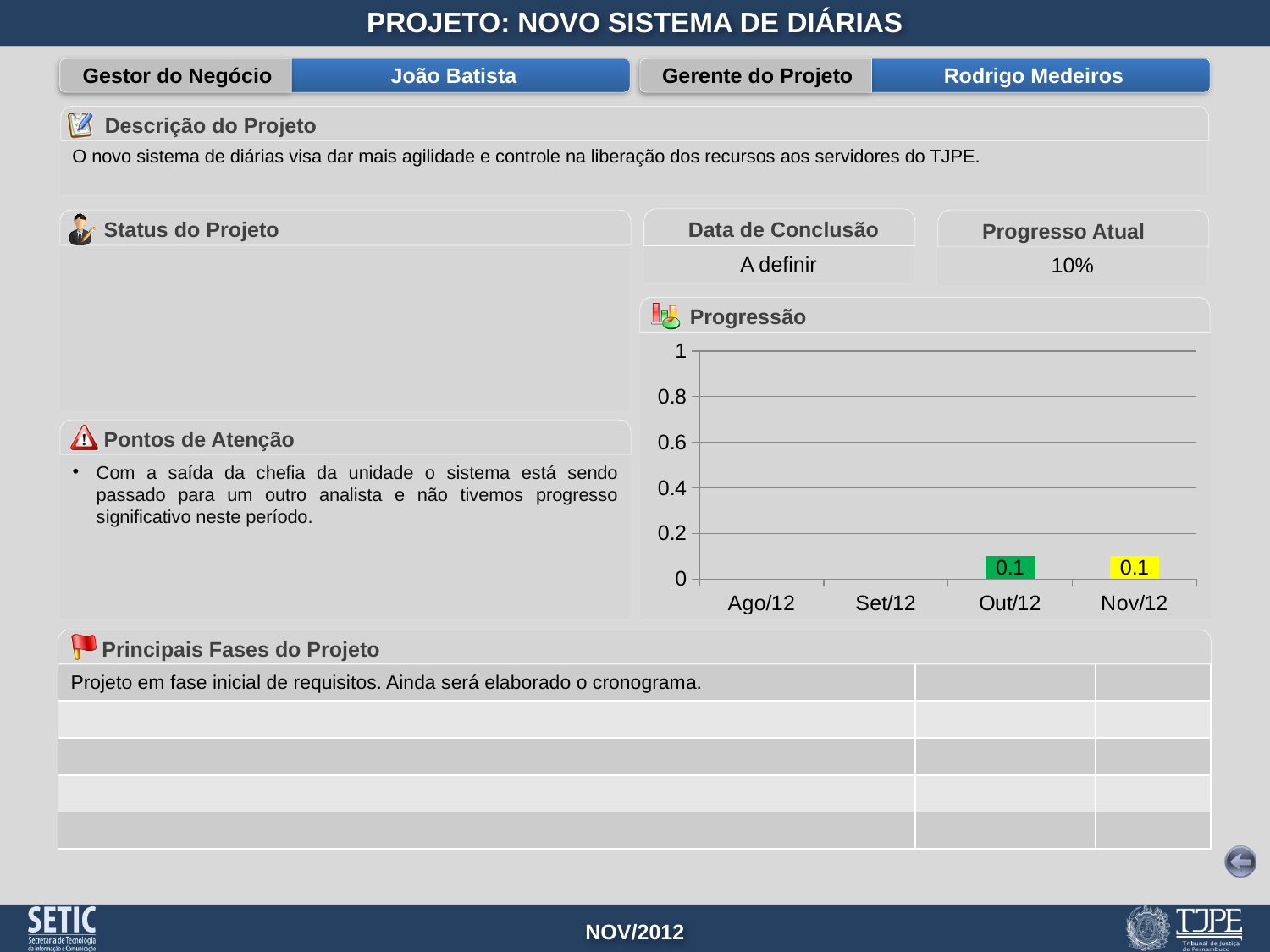
What is the highest tick value on the y axis of the Progressão chart? 1 What is the value shown for Out/12 in the Progressão chart? 0.1 What is the value shown for Nov/12 in the Progressão chart? 0.1 How many months are listed on the x axis of the Progressão chart? 4 What is the title of the chart on the slide? Progressão Is the value for Nov/12 in the Progressão chart greater or less than 0.2? less Is the value for Out/12 in the Progressão chart greater or less than 0.4? less What kind of chart is the Progressão chart? bar chart What is the difference between the values for Out/12 and Nov/12 in the Progressão chart? 0 Which is the first month shown on the x axis of the Progressão chart? Ago/12 Does the value rise, fall or stay the same from Out/12 to Nov/12 in the Progressão chart? stays the same